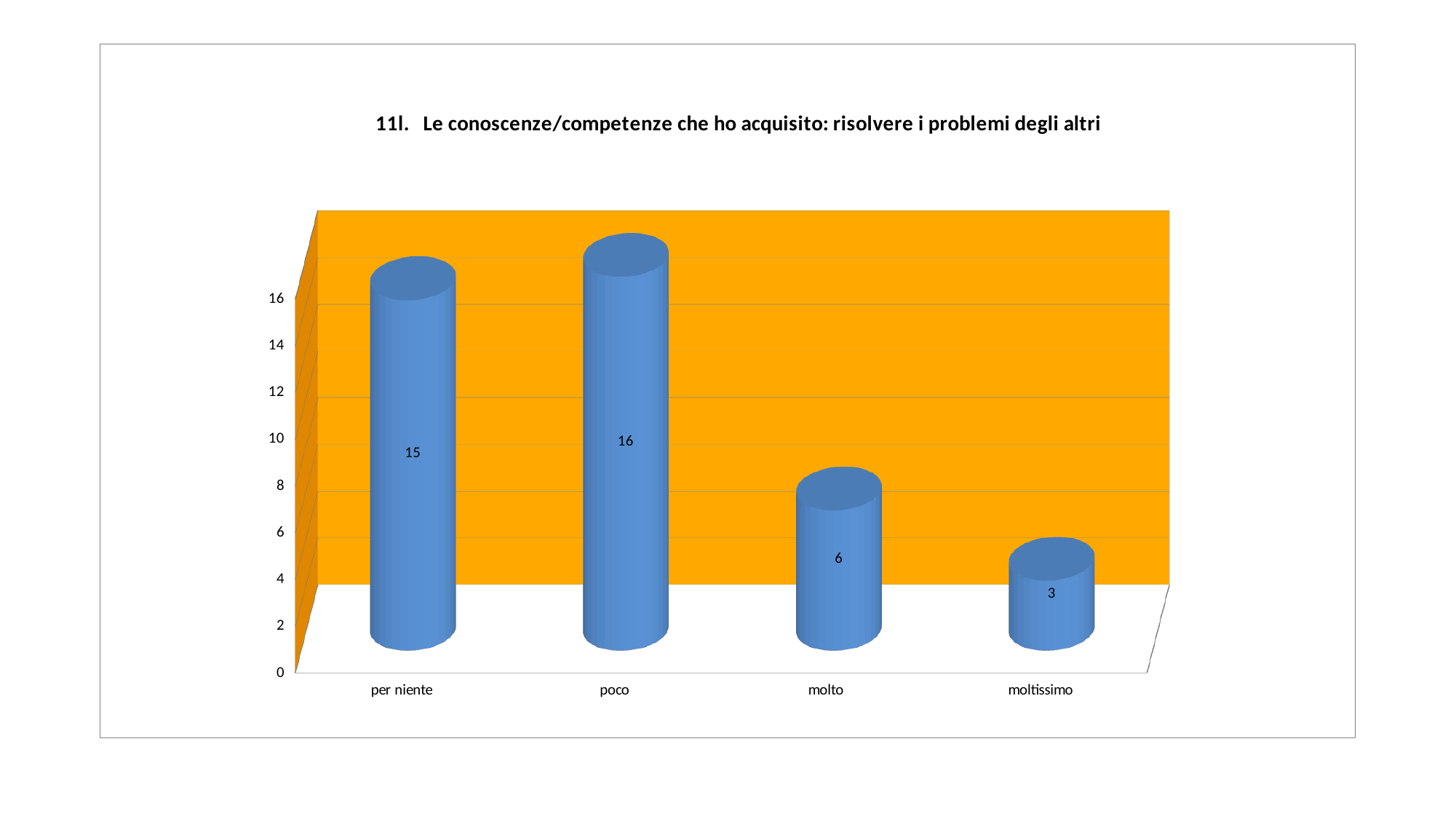
What is the difference between the values for "poco" and "molto"? 10 What is the title of the chart? 11l. Le conoscenze/competenze che ho acquisito: risolvere i problemi degli altri Is the value for "molto" greater or less than 10? less How many categories are shown on the x axis? 4 What kind of chart is shown on the slide? bar chart Which category has the highest value? poco Which category has the lowest value? moltissimo What is the value for "poco"? 16 Which is larger, the value for "molto" or the value for "moltissimo"? molto What is the value for "moltissimo"? 3 What is the total of all four values shown? 40 What is the value for "per niente"? 15